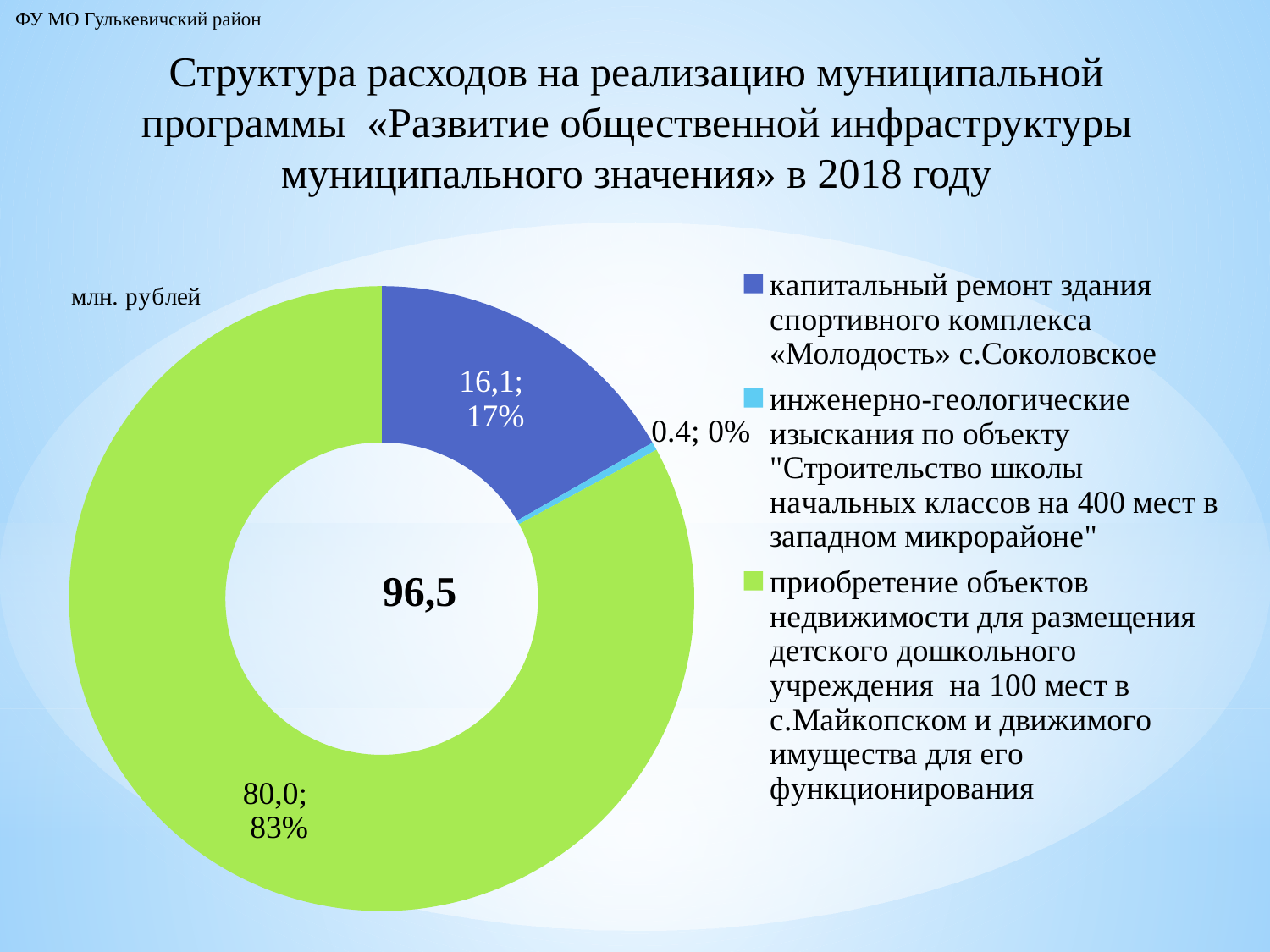
What kind of chart is shown on the slide? doughnut (pie) chart What is the difference between the value for «приобретение объектов недвижимости» and the value for «капитальный ремонт здания спортивного комплекса «Молодость»»? 63,9 What share of the chart does «капитальный ремонт здания спортивного комплекса «Молодость» с.Соколовское» take? 17% What total value is shown in the centre of the chart? 96,5 What is the value for «капитальный ремонт здания спортивного комплекса «Молодость» с.Соколовское»? 16,1 Which category has the largest slice? приобретение объектов недвижимости для размещения детского дошкольного учреждения на 100 мест в с.Майкопском и движимого имущества для его функционирования Which is larger: the value for «капитальный ремонт здания спортивного комплекса «Молодость»» or the value for «инженерно-геологические изыскания»? капитальный ремонт здания спортивного комплекса «Молодость» с.Соколовское How many categories does the chart show? 3 What is the value for «инженерно-геологические изыскания по объекту "Строительство школы начальных классов на 400 мест в западном микрорайоне"»? 0.4 Which category has the smallest slice? инженерно-геологические изыскания по объекту "Строительство школы начальных классов на 400 мест в западном микрорайоне" What share of the chart does «приобретение объектов недвижимости для размещения детского дошкольного учреждения» take? 83% What is the value for «приобретение объектов недвижимости для размещения детского дошкольного учреждения на 100 мест в с.Майкопском и движимого имущества для его функционирования»? 80,0